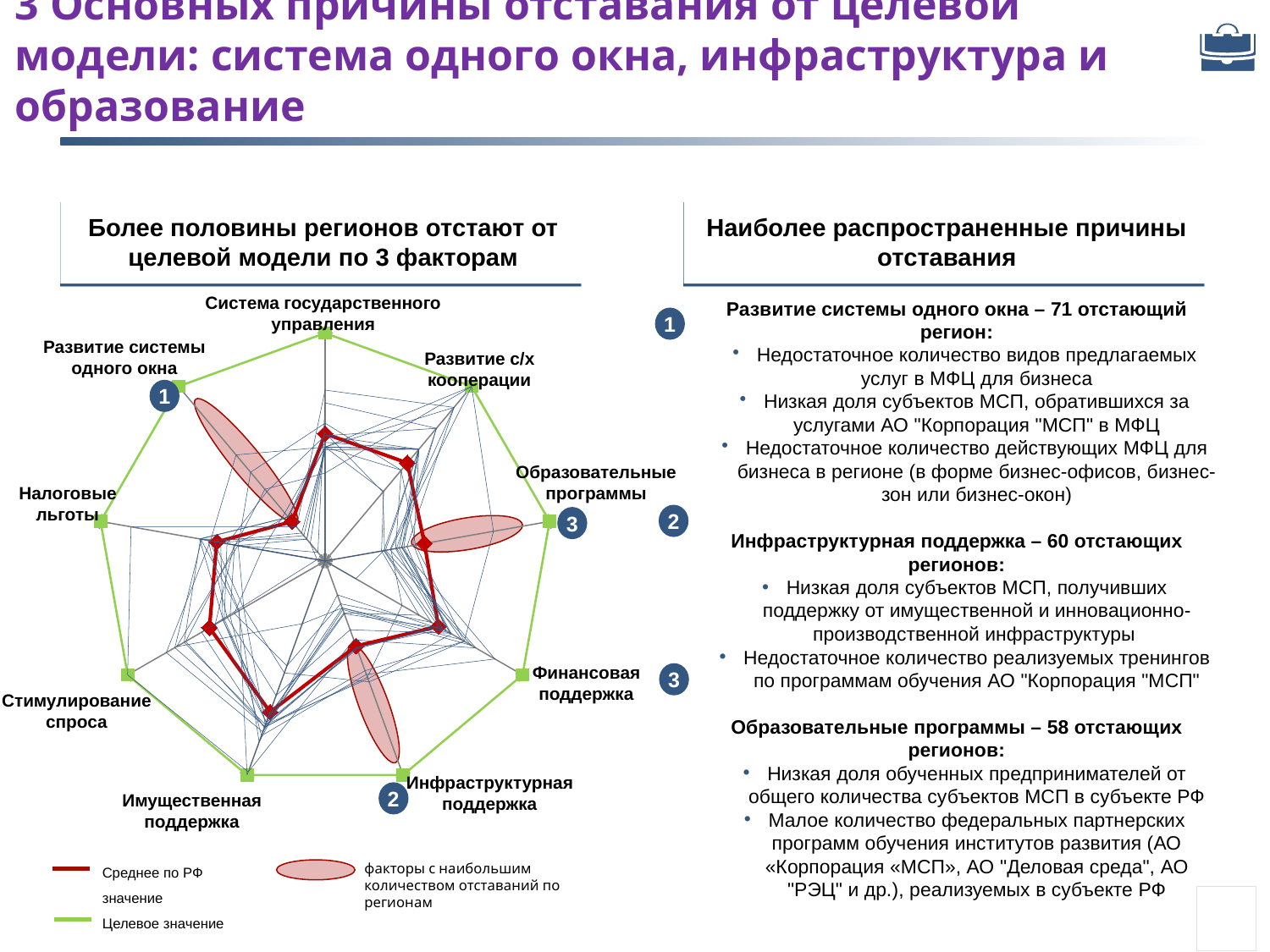
How many line series does the radar chart legend list? 2 How many factors (axes) does the radar chart have? 9 Which series does the green line on the radar chart represent? Целевое значение What kind of chart is shown on the left of the slide? Radar chart Which three factors are highlighted with ellipses on the radar chart as having the most lagging regions? Развитие системы одного окна, Образовательные программы, Инфраструктурная поддержка Which factor on the radar chart is marked with the number 2? Инфраструктурная поддержка On the Развитие системы одного окна axis of the radar chart, is the Среднее по РФ значение line inside or outside the Целевое значение line? Inside On the Налоговые льготы axis of the radar chart, which series lies further from the centre: Среднее по РФ значение or Целевое значение? Целевое значение